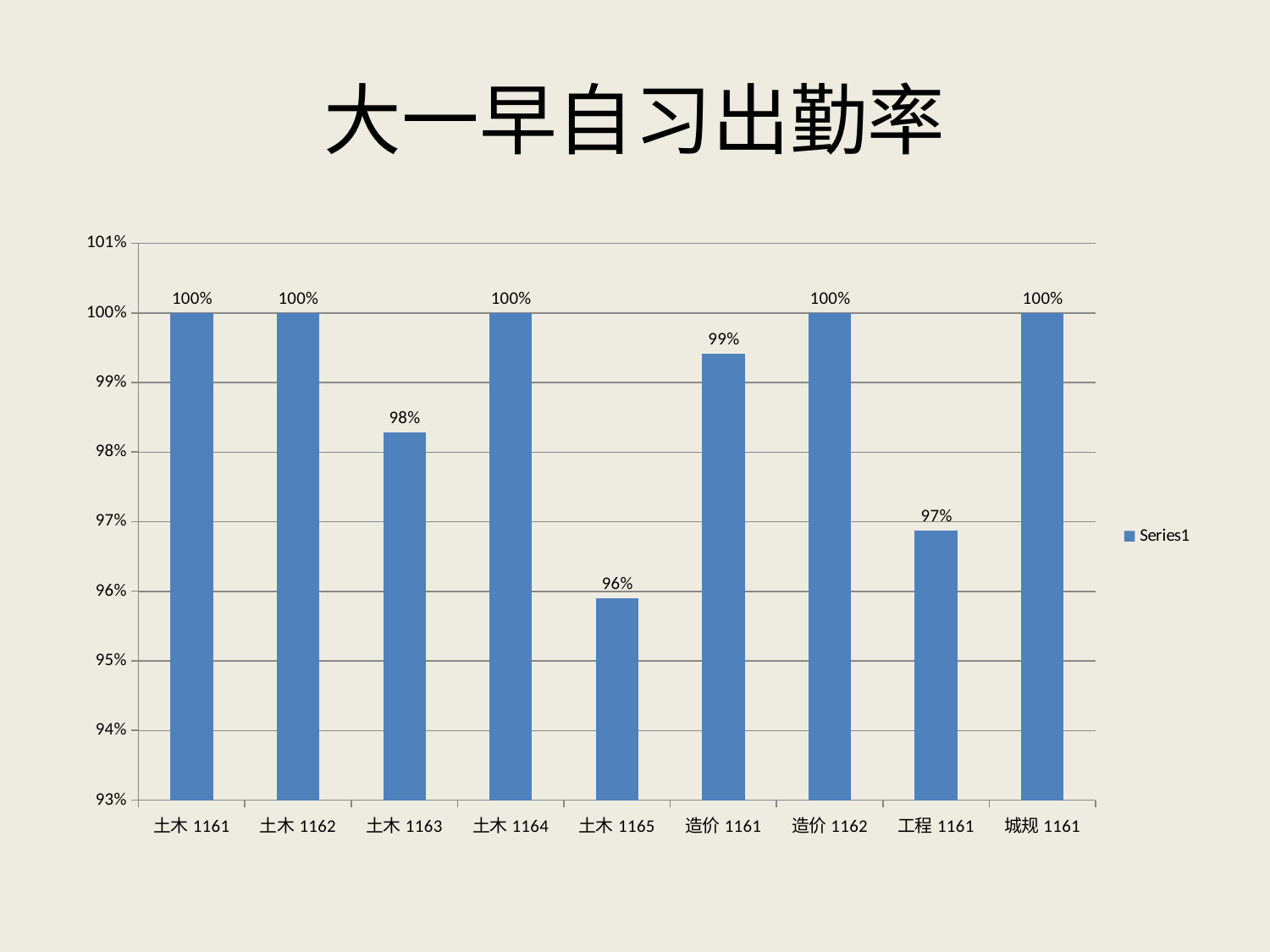
What is the difference between the value for 土木 1161 and the value for 土木 1165? 4% Is the value for 造价 1161 greater or less than 98%? greater How many categories are shown on the x axis? 9 Which is larger, the value for 土木 1163 or the value for 工程 1161? 土木 1163 Which category has the lowest value? 土木 1165 What kind of chart is shown on the slide? bar chart What is the title of the chart? 大一早自习出勤率 What is the value for 造价 1161? 99% How many series does the legend list? 1 What is the value for 土木 1163? 98% What is the value for 土木 1165? 96% What is the value for 工程 1161? 97%